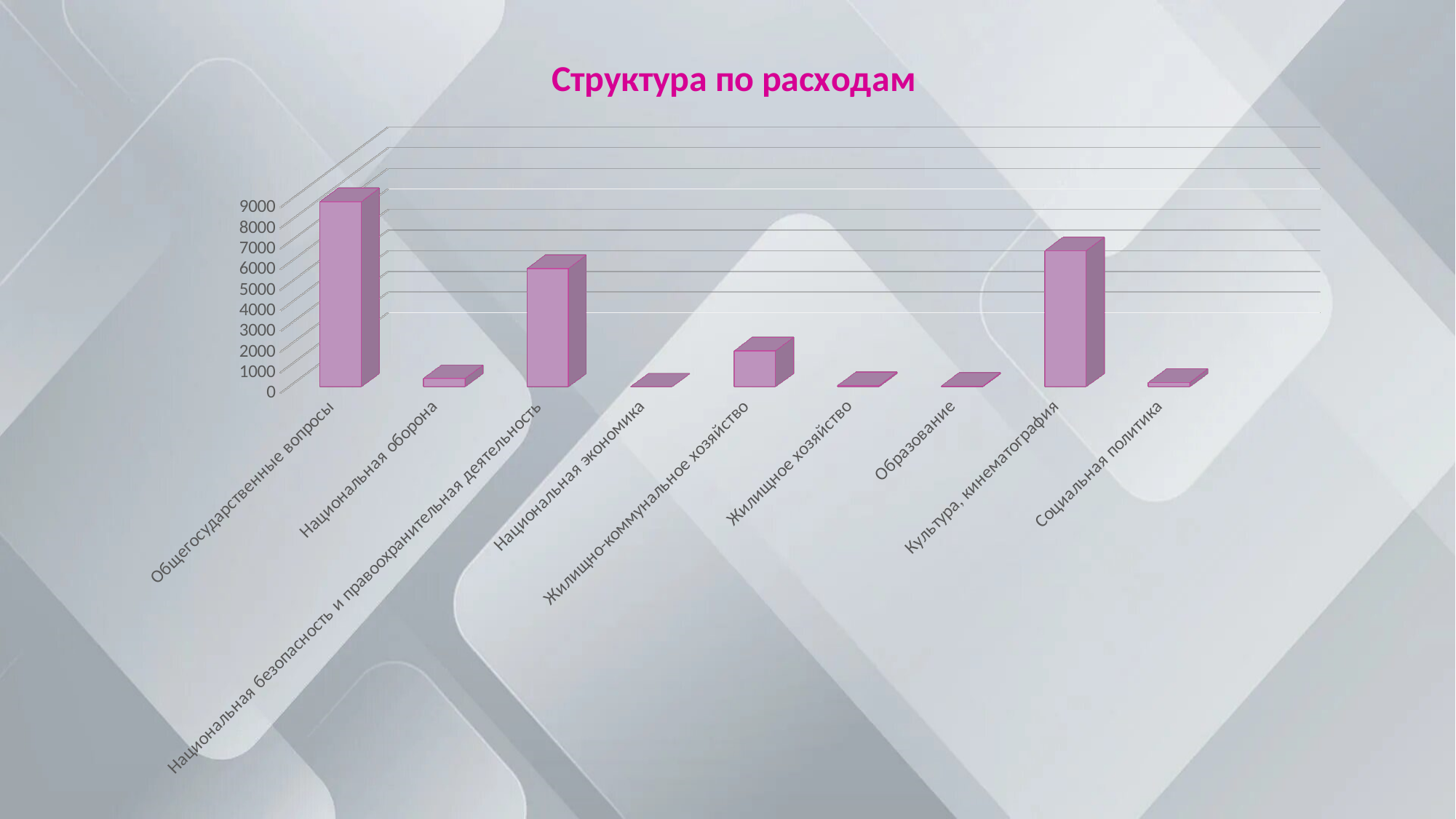
Which is larger: the value for Общегосударственные вопросы or the value for Культура, кинематография? Общегосударственные вопросы Which category has the highest value in the chart? Общегосударственные вопросы How many categories are shown on the x axis of the chart? 9 What is the title of the chart? Структура по расходам Is the value for Жилищно-коммунальное хозяйство greater or less than 3000? less Which is larger: the value for Жилищно-коммунальное хозяйство or the value for Национальная оборона? Жилищно-коммунальное хозяйство What kind of chart is shown on the slide? bar chart Is the value for Национальная оборона greater or less than 1000? less Is the value for Общегосударственные вопросы greater or less than 7000? greater Which is larger: the value for Культура, кинематография or the value for Национальная безопасность и правоохранительная деятельность? Культура, кинематография